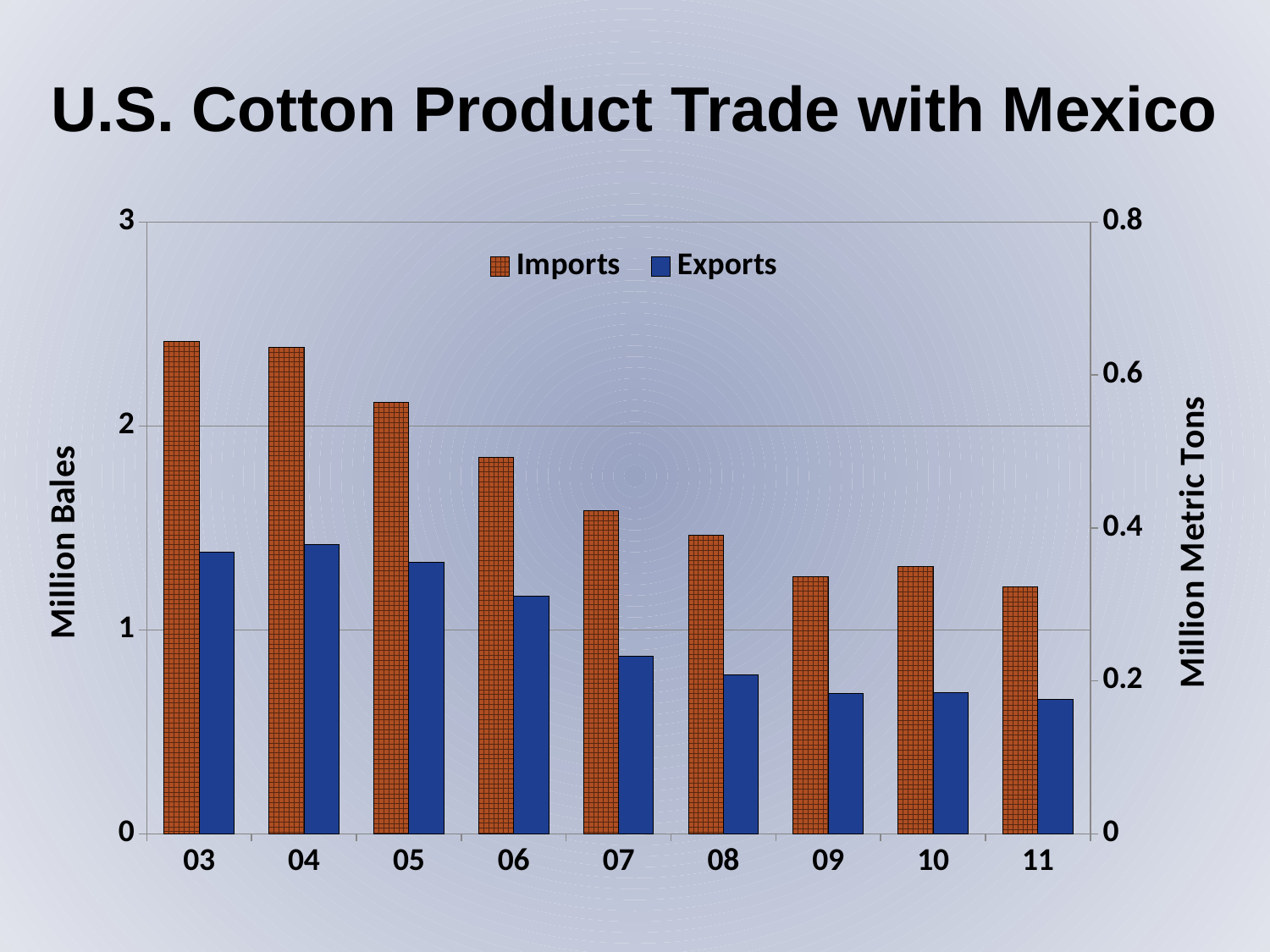
Is the Exports value for 03 greater or less than 1 million bales? greater What is the label on the left vertical axis? Million Bales Which is larger, Imports in 05 or Imports in 08? Imports in 05 What kind of chart is shown on the slide? bar chart Is the Imports value for 11 greater or less than 1 million bales? greater Is the Imports value for 03 greater or less than 2 million bales? greater How many years are shown on the x axis? 9 Do the Imports values generally rise or fall from 03 to 11? fall Which is larger in 03, Imports or Exports? Imports How many series does the legend list? 2